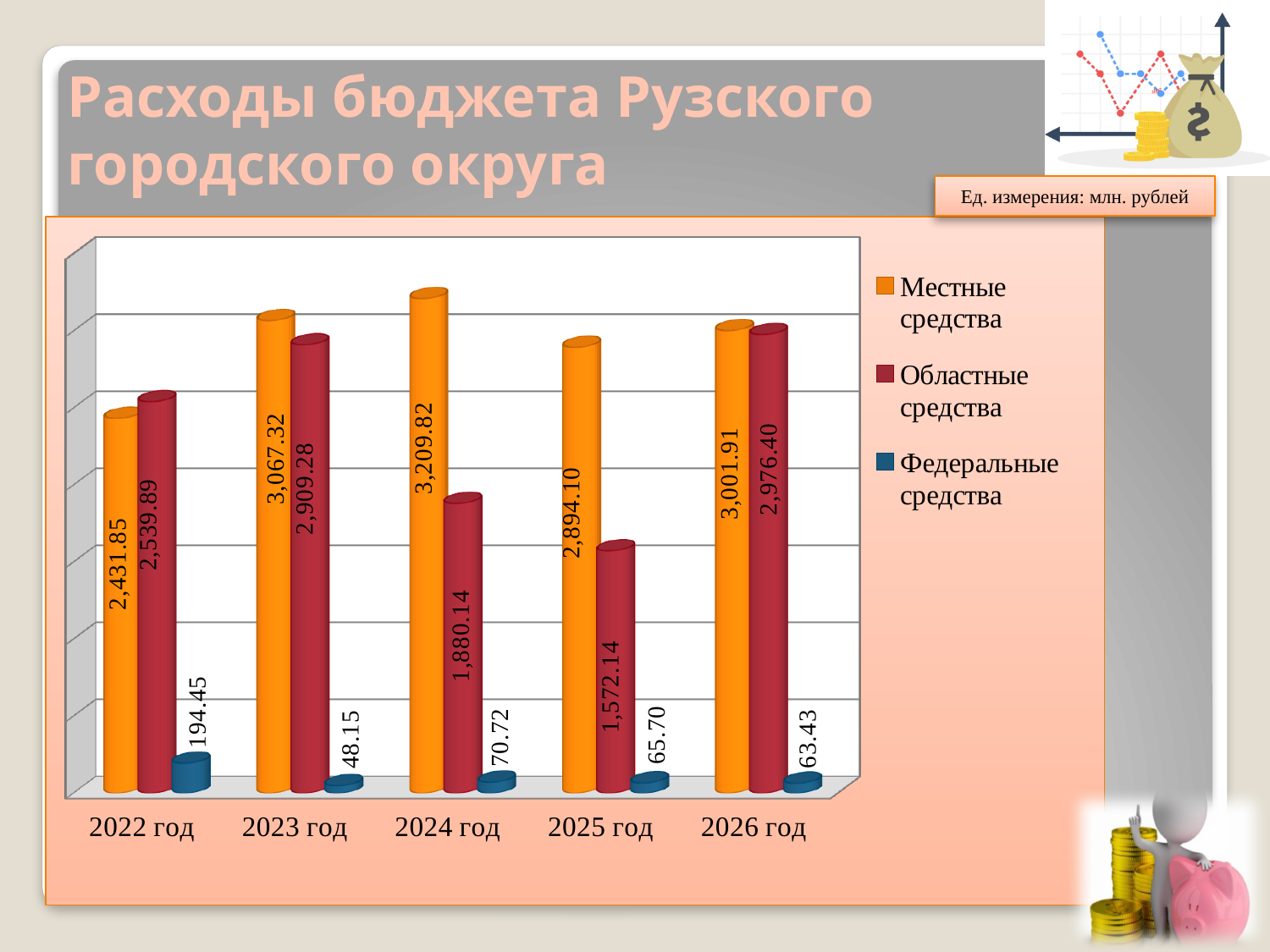
What unit of measurement is stated on the slide? млн. рублей Do Областные средства rise or fall from 2023 год to 2025 год? Fall In which year are Местные средства highest? 2024 год What is the difference between Местные средства and Областные средства in 2024 год? 1,329.68 How many years are shown on the x axis? 5 What kind of chart is shown on the slide? Bar chart In which year are Федеральные средства lowest? 2023 год How many series does the legend list? 3 What is the value of Областные средства for 2025 год? 1,572.14 What is the value of Федеральные средства for 2022 год? 194.45 Which is larger in 2022 год: Местные средства or Областные средства? Областные средства What is the value of Местные средства for 2024 год? 3,209.82